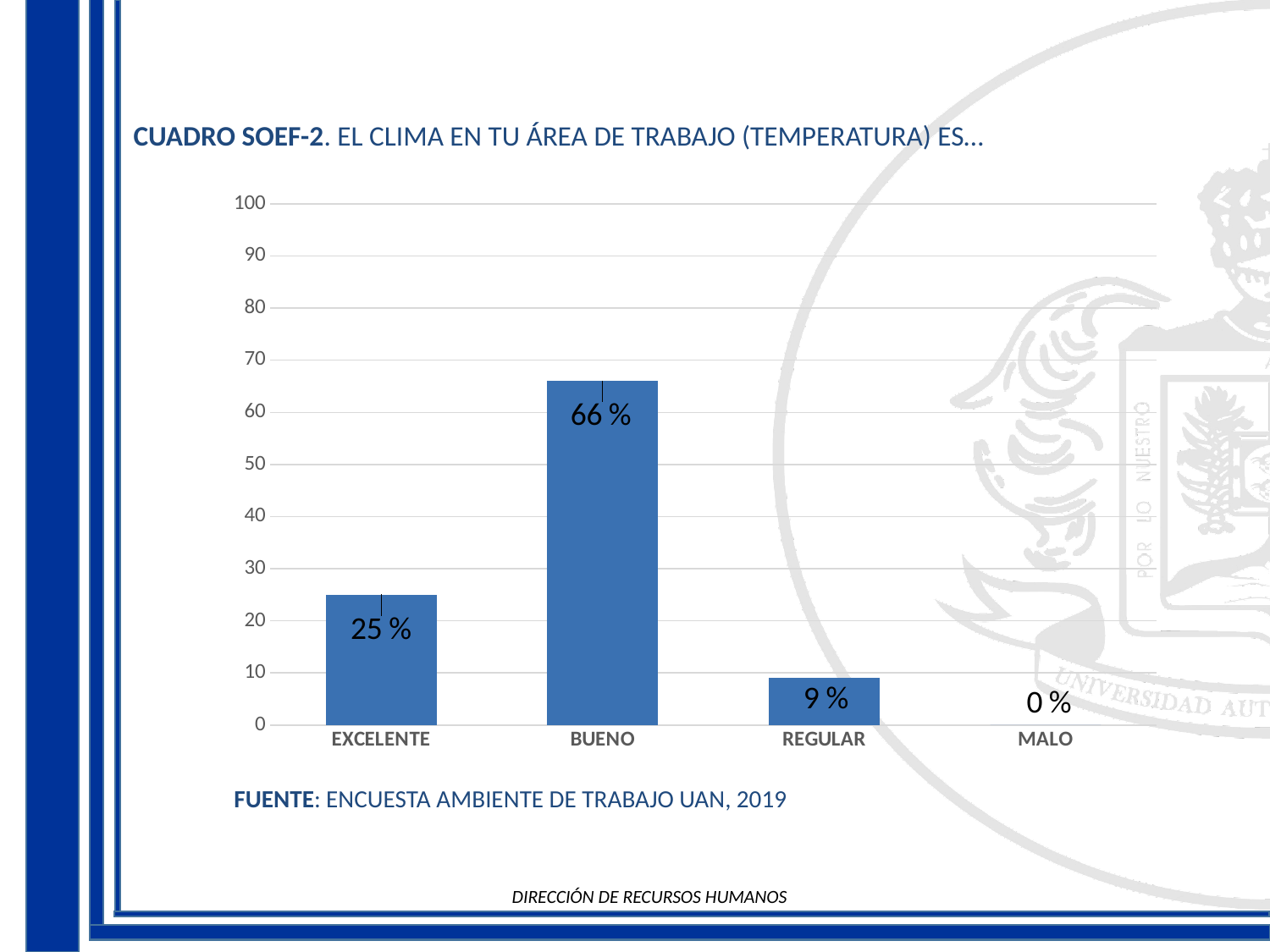
What is the value for EXCELENTE? 25 % What is the difference between the values for BUENO and EXCELENTE? 41 % What is the value for BUENO? 66 % What kind of chart is shown on the slide? bar chart What is the value for MALO? 0 % Which category has the highest value? BUENO Which category has the lowest value? MALO Which is larger, the value for EXCELENTE or the value for REGULAR? EXCELENTE What is the value for REGULAR? 9 % How many categories are shown on the x axis? 4 Is the value for BUENO greater or less than 50? greater What source is cited below the chart? ENCUESTA AMBIENTE DE TRABAJO UAN, 2019